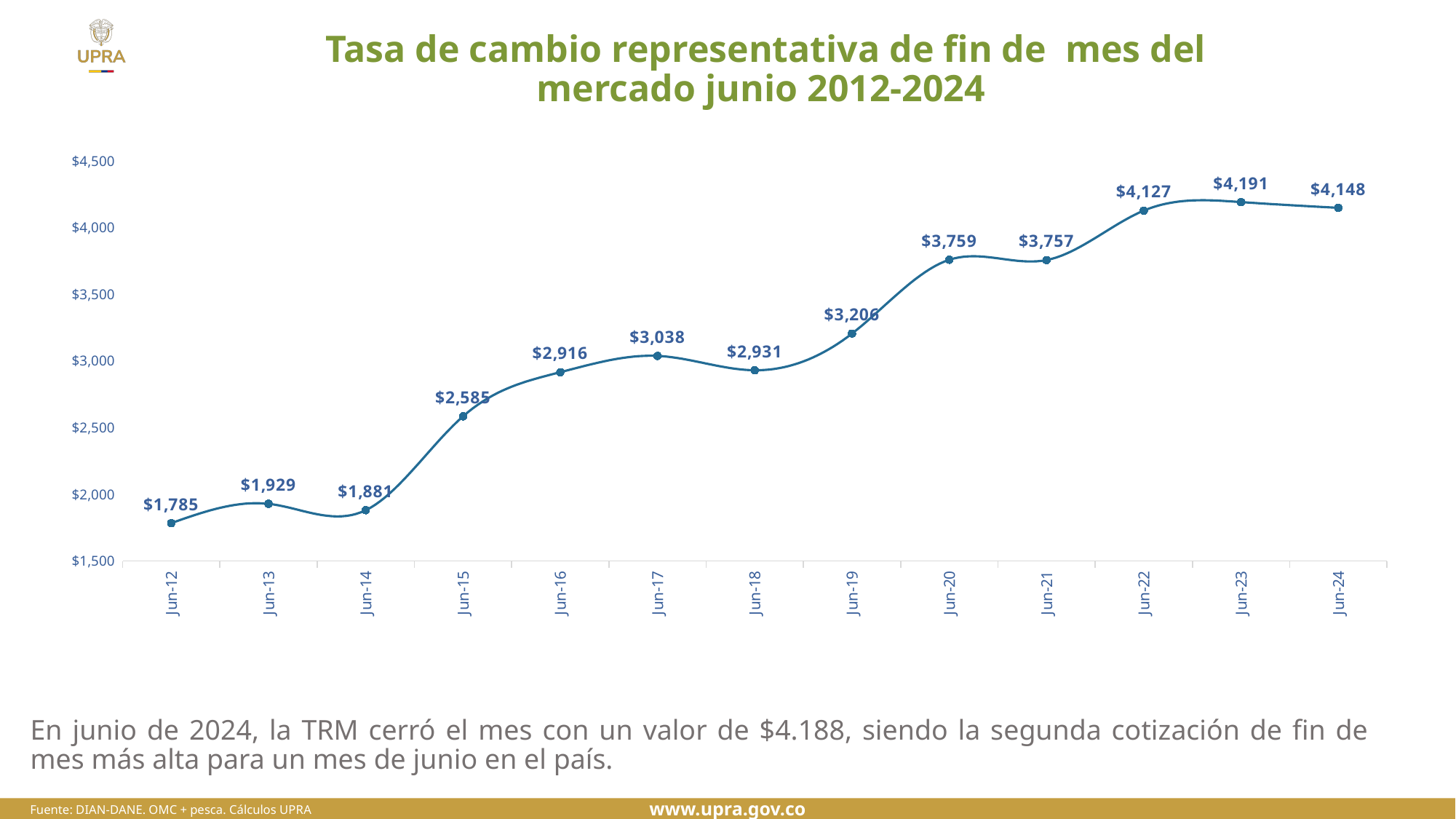
How many data points are plotted on the chart? 13 Which is larger, the value for Jun-17 or the value for Jun-18? Jun-17 What is the value for Jun-24? $4,148 Which month has the lowest value? Jun-12 Which month has the highest value? Jun-23 What is the value for Jun-12? $1,785 What kind of chart is shown on the slide? line chart Do the values generally rise or fall from Jun-12 to Jun-24? rise Is the value for Jun-22 greater or less than $4,000? greater What is the value for Jun-19? $3,206 What is the difference between the values for Jun-24 and Jun-12? $2,363 What is the difference between the values for Jun-15 and Jun-14? $704